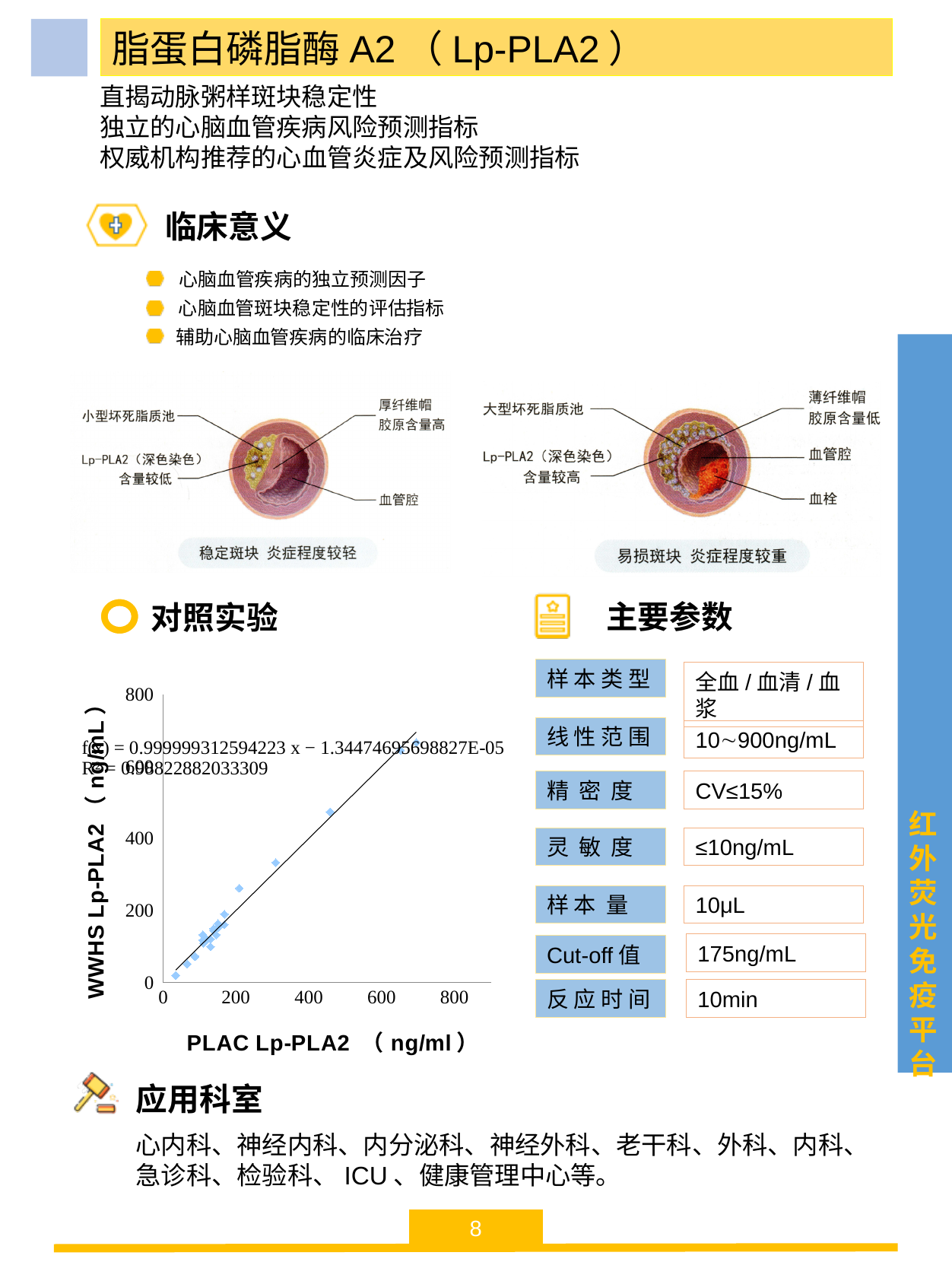
In the 对照实验 scatter chart, which point has the higher y value: the point near x = 450 or the point near x = 300? the point near x = 450 In the 对照实验 scatter chart, do the WWHS Lp-PLA2 values rise or fall as the PLAC Lp-PLA2 values increase along the x axis? rise In the 对照实验 scatter chart, what is the label of the y axis? WWHS Lp-PLA2 (ng/mL) In the 对照实验 scatter chart, is the y value of the point located near x = 300 greater or less than 400? less What kind of chart is shown under the heading 对照实验? scatter chart In the 对照实验 scatter chart, is the y value of the point with the largest x value greater or less than 600? greater In the 对照实验 scatter chart, is the y value of the point located near x = 450 greater or less than 400? greater In the 对照实验 scatter chart, what is the highest tick value shown on the y axis? 800 In the 对照实验 scatter chart, what is the label of the x axis? PLAC Lp-PLA2 (ng/ml) In the 对照实验 scatter chart, what is the highest tick value shown on the x axis? 800